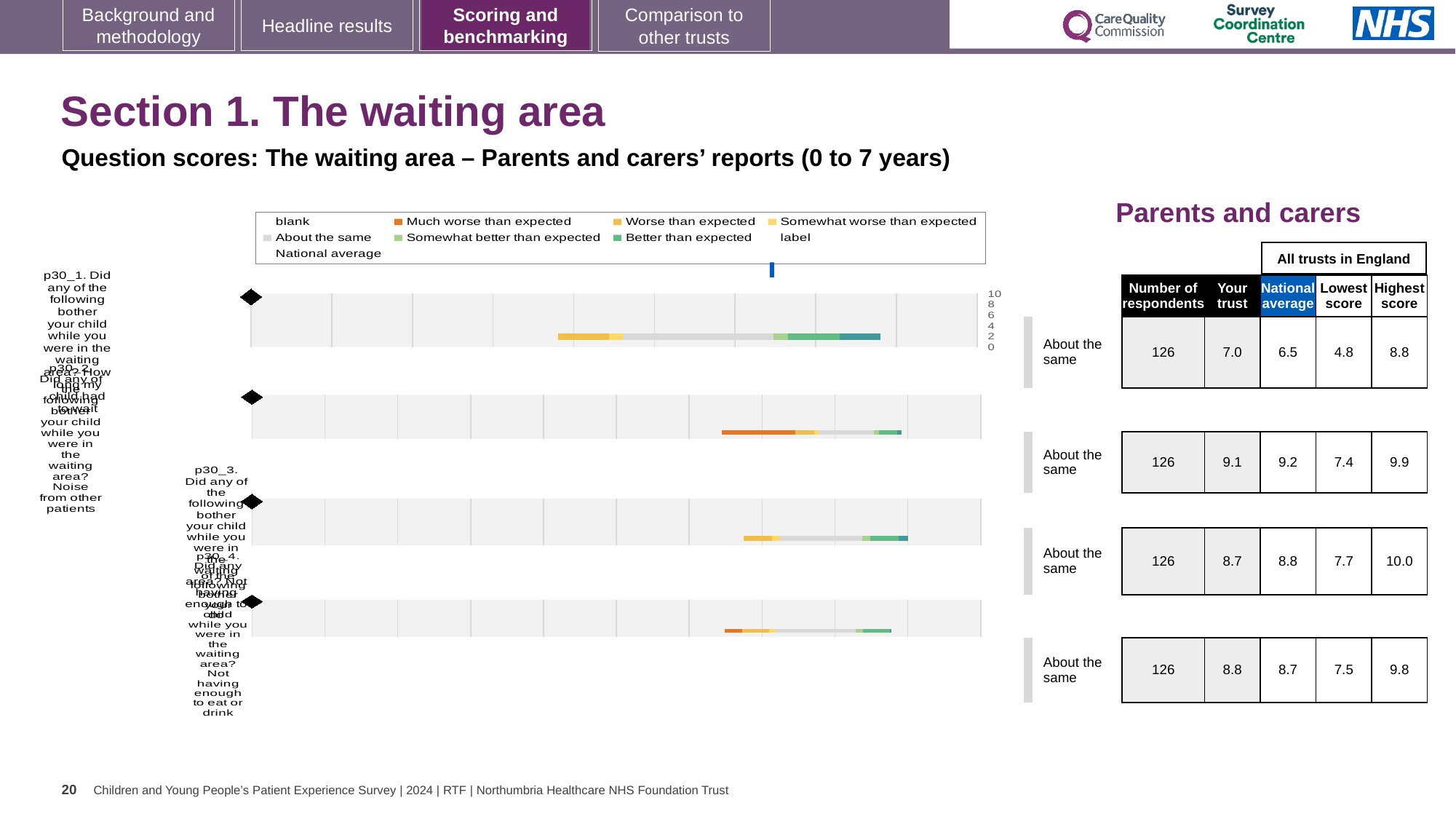
In the table beside the chart, what is the 'Your trust' score in the second row? 9.1 In the table beside the chart, what is the 'Highest score' in the first row? 8.8 What is the highest value shown on the chart's score axis? 10 In the table beside the chart, which row has the highest 'Your trust' score? the second row (9.1) What colour does the legend use for 'Much worse than expected'? orange What is the subtitle describing the chart's question scores? Question scores: The waiting area – Parents and carers' reports (0 to 7 years) How many question bars are plotted in the chart? 4 In the table beside the chart, in the third row, which is larger: 'Your trust' or 'National average'? National average In the table beside the chart, what is the 'Lowest score' in the fourth row? 7.5 In the table beside the chart, what is the number of respondents for the first row? 126 What kind of chart is shown on the slide? bar chart In the table beside the chart, what is the difference between 'Your trust' (7.0) and 'National average' (6.5) in the first row? 0.5